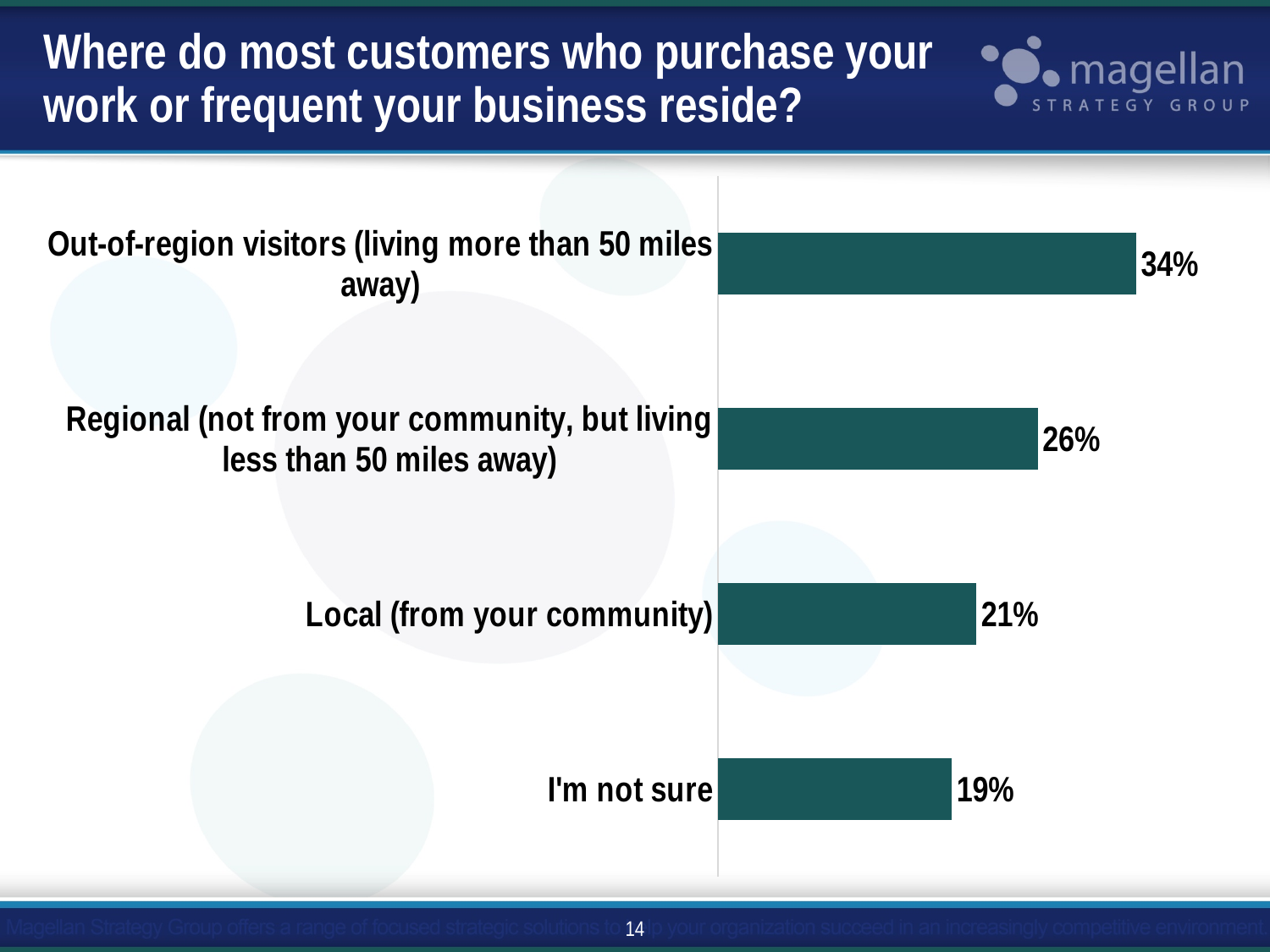
Which category has the lowest percentage? I'm not sure What percentage of respondents said most customers are regional (not from your community, but living less than 50 miles away)? 26% What question does the chart's title ask? Where do most customers who purchase your work or frequent your business reside? Which category has the highest percentage? Out-of-region visitors (living more than 50 miles away) How many categories are shown in the chart? 4 What percentage of respondents answered "I'm not sure"? 19% What is the difference in percentage points between local customers and "I'm not sure"? 2 percentage points What percentage of respondents said most customers are out-of-region visitors (living more than 50 miles away)? 34% What percentage of respondents said most customers are local (from your community)? 21% What type of chart is shown on the slide? Bar chart What is the difference in percentage points between out-of-region visitors and regional customers? 8 percentage points Which is larger: the percentage for regional customers or for local customers? Regional (not from your community, but living less than 50 miles away)